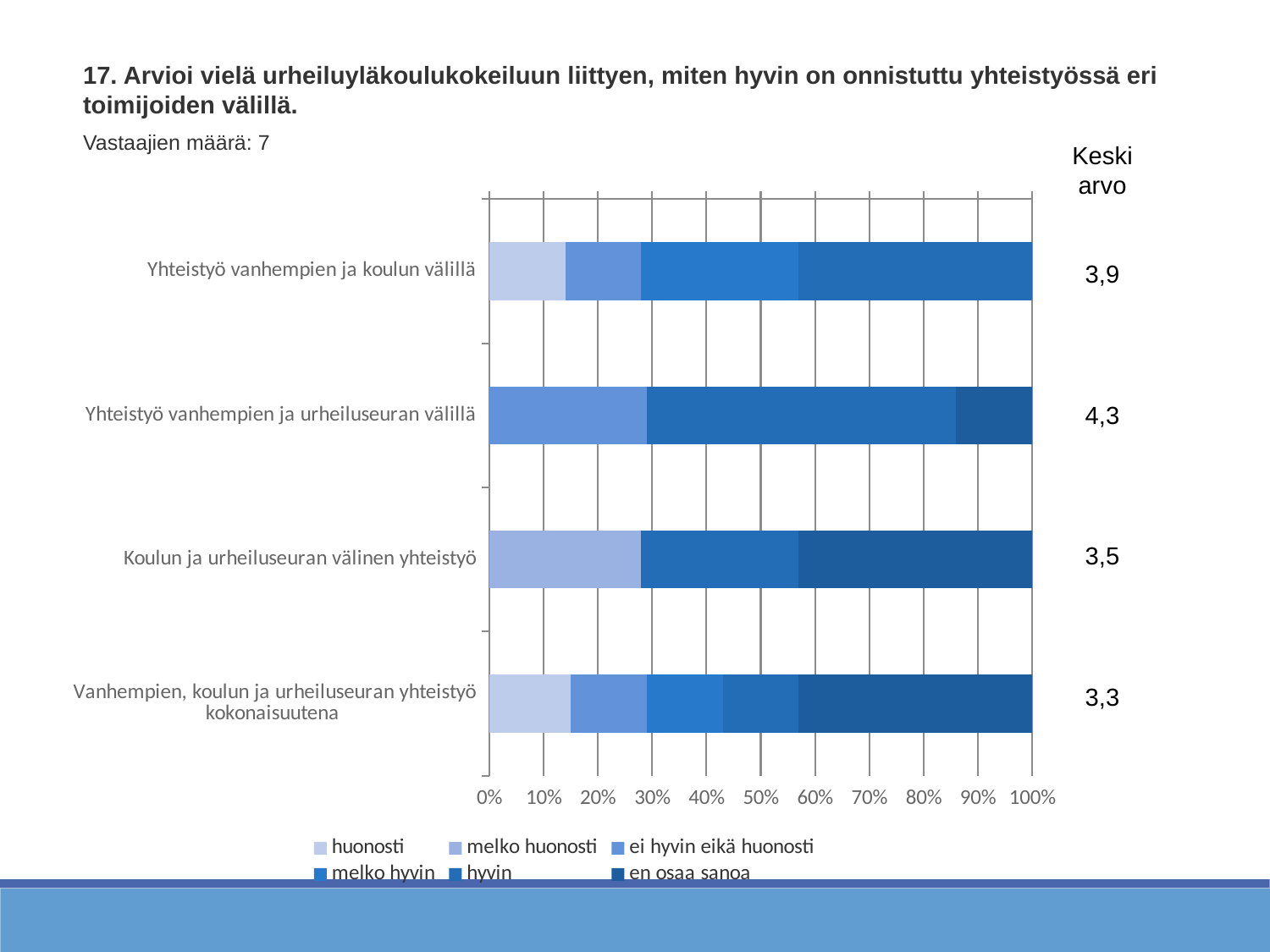
What is the total of the stacked bar for "Yhteistyö vanhempien ja koulun välillä"? 100% Which has the larger Keskiarvo value: "Yhteistyö vanhempien ja koulun välillä" or "Koulun ja urheiluseuran välinen yhteistyö"? Yhteistyö vanhempien ja koulun välillä How many categories are plotted on the chart? 4 What is the difference between the Keskiarvo values of "Yhteistyö vanhempien ja urheiluseuran välillä" and "Vanhempien, koulun ja urheiluseuran yhteistyö kokonaisuutena"? 1,0 How many respondents (Vastaajien määrä) does the slide report? 7 Which category has the lowest Keskiarvo value? Vanhempien, koulun ja urheiluseuran yhteistyö kokonaisuutena How many series does the legend list? 6 Which category has the highest Keskiarvo value? Yhteistyö vanhempien ja urheiluseuran välillä What is the Keskiarvo value shown for "Vanhempien, koulun ja urheiluseuran yhteistyö kokonaisuutena"? 3,3 What kind of chart is shown on the slide? bar chart What is the Keskiarvo value shown for "Yhteistyö vanhempien ja urheiluseuran välillä"? 4,3